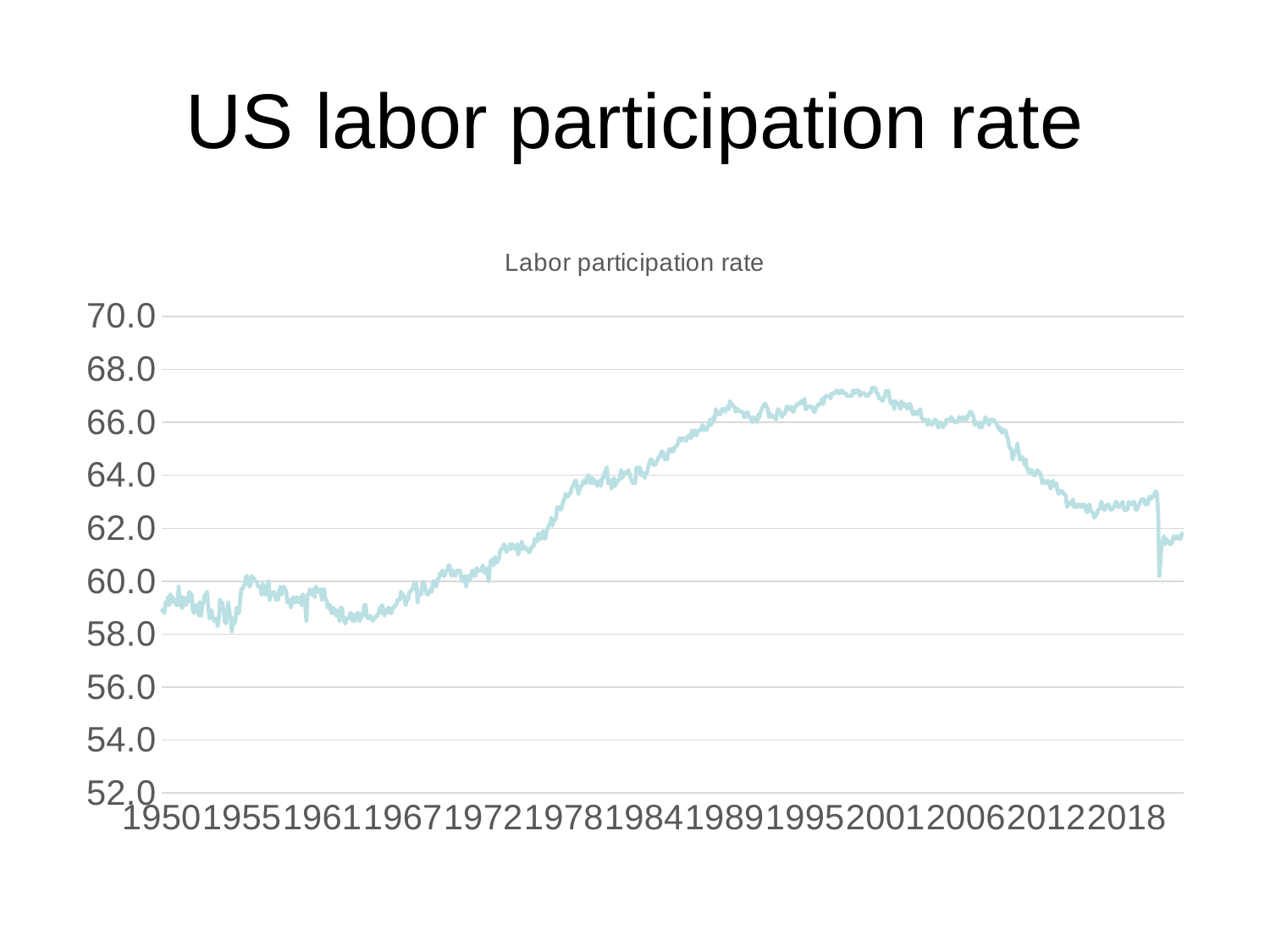
Which year has the higher labor participation rate, 1961 or 1995? 1995 Does the line rise or fall between 1961 and 1995? rise What kind of chart is shown on the slide? line chart What is the highest value shown on the y axis? 70.0 Is the value at the start of the line, around 1950, greater or less than 60.0? less Is the highest point of the line greater or less than 68.0? less Is the value at the end of the line, around 2018, greater or less than 64.0? less What is the title printed above the chart? Labor participation rate Does the line rise or fall between 2006 and 2018? fall How many year labels are shown on the x axis? 13